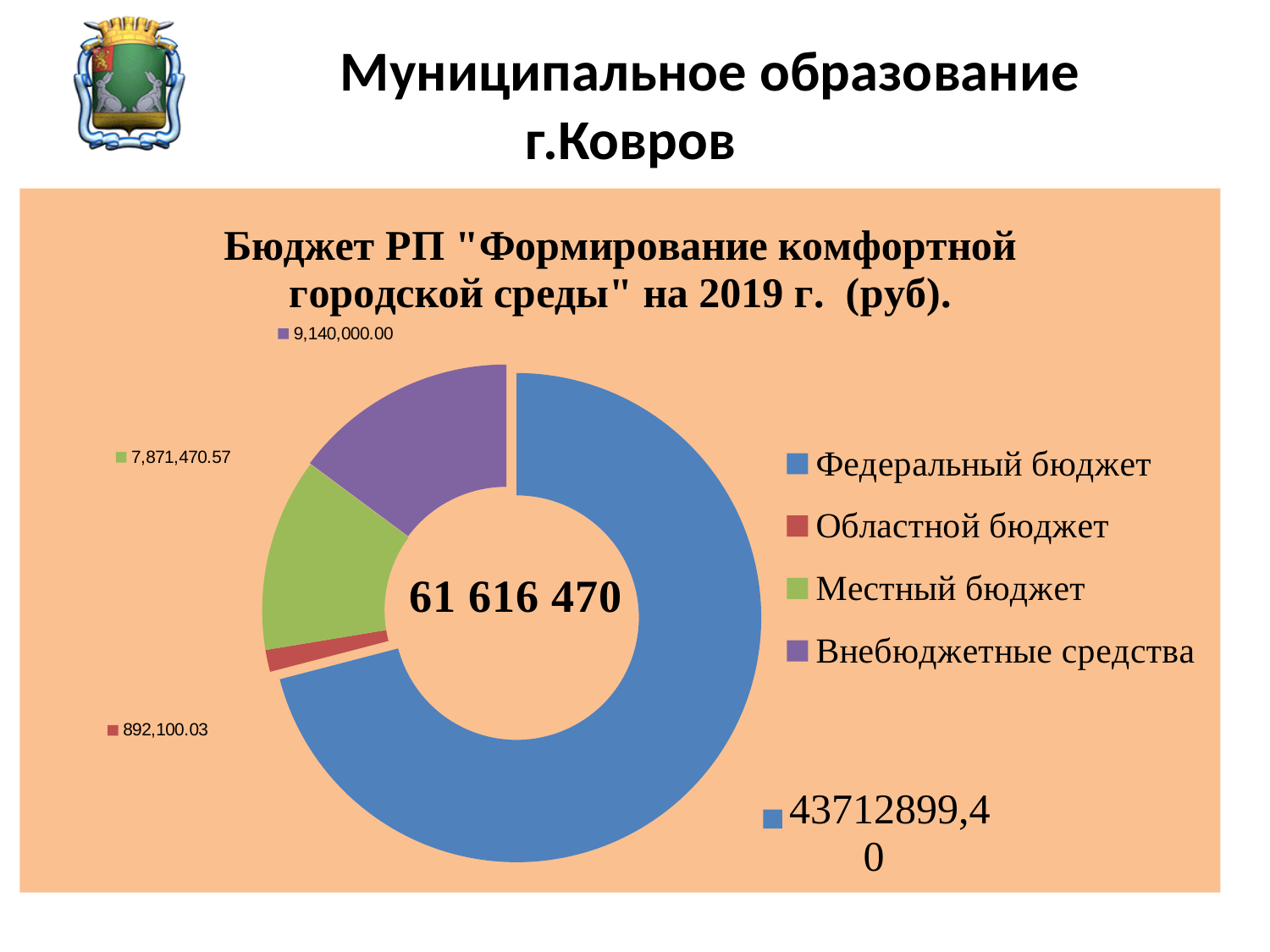
Which category has the largest value? Федеральный бюджет What is the difference between Внебюджетные средства and Местный бюджет? 1,268,529.43 What kind of chart is shown on the slide? doughnut chart What is the value for Внебюджетные средства? 9,140,000.00 What is the value for Федеральный бюджет? 43712899,40 Which category has the smallest value? Областной бюджет How many categories does the chart show? 4 What is the title of the chart? Бюджет РП "Формирование комфортной городской среды" на 2019 г. (руб). What total value is shown in the centre of the chart? 61 616 470 What is the value for Местный бюджет? 7,871,470.57 Which is larger, Местный бюджет or Внебюджетные средства? Внебюджетные средства What is the value for Областной бюджет? 892,100.03